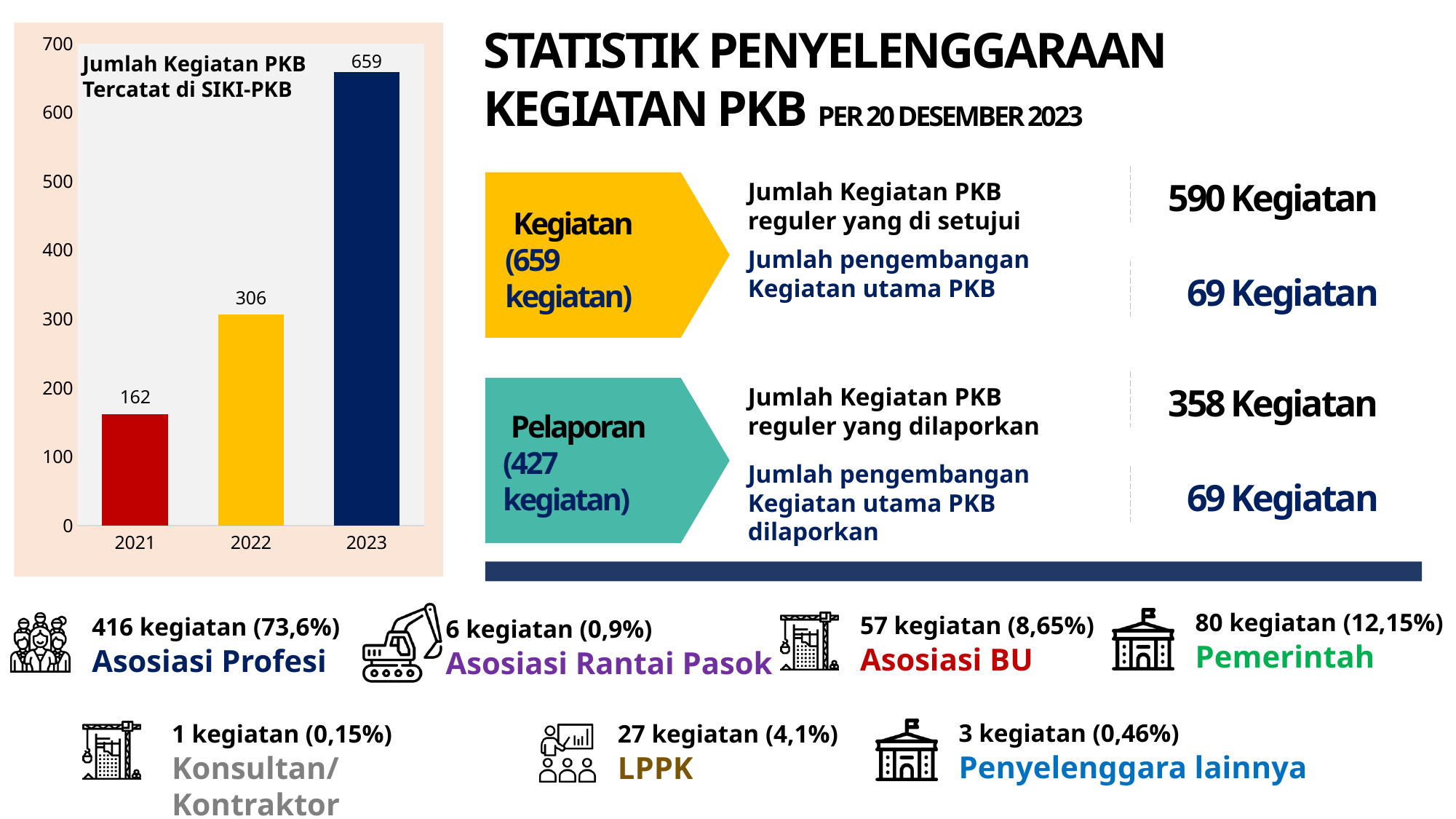
What kind of chart is shown on the slide? bar chart What is the value for 2021 in the chart? 162 Which year has the lowest value in the chart? 2021 What is the value for 2023 in the chart? 659 Which is larger, the value for 2022 or the value for 2021? 2022 How many years are shown on the x axis of the chart? 3 Which year has the highest value in the chart? 2023 What is the value for 2022 in the chart? 306 What is the difference between the values for 2022 and 2021? 144 Is the value for 2023 greater or less than 600? greater What is the difference between the values for 2023 and 2022? 353 Do the values rise or fall from 2021 to 2023? rise